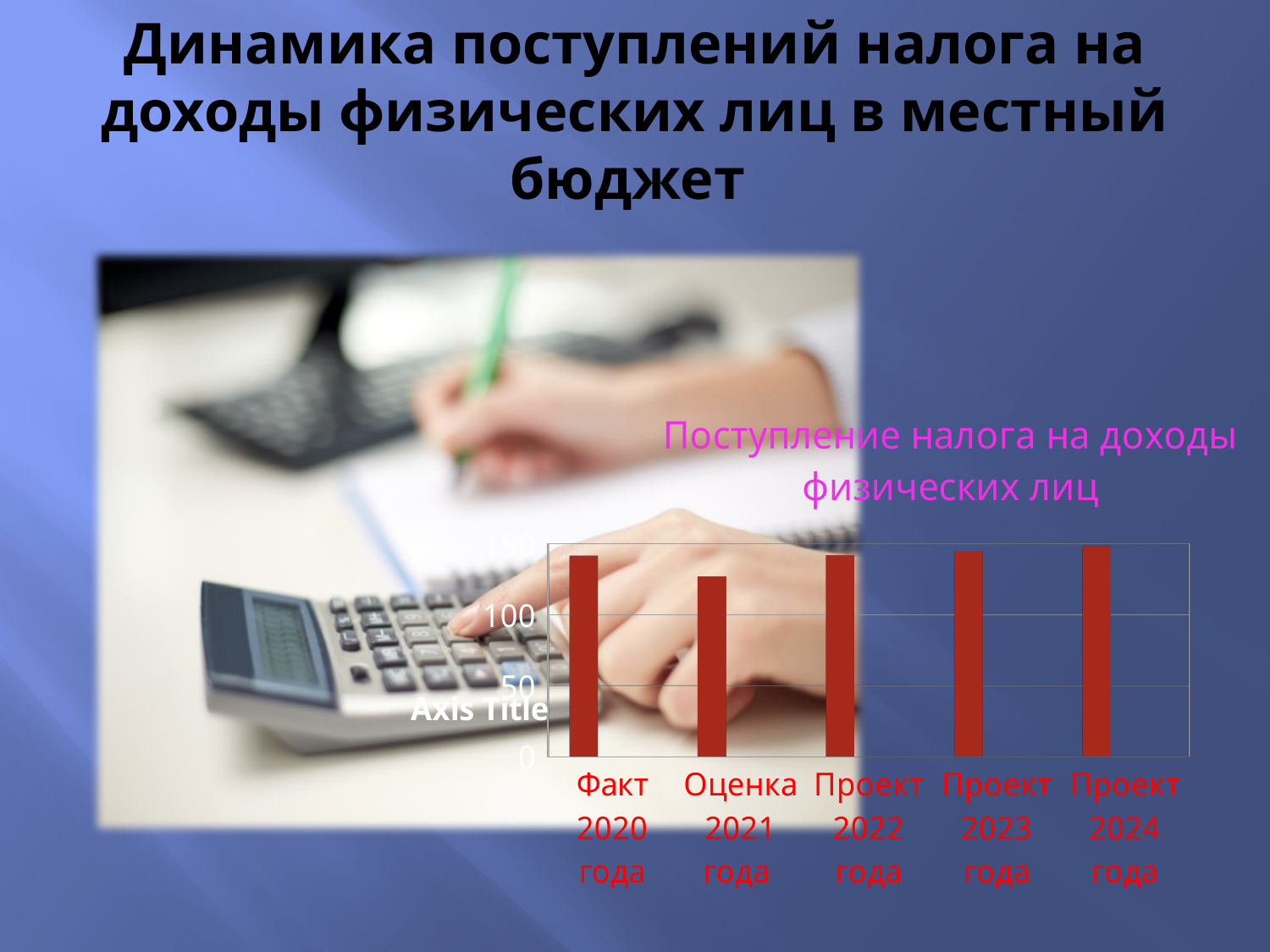
Is the value for Оценка 2021 года greater or less than 150? less Is the value for Проект 2024 года greater or less than 100? greater What kind of chart is shown on the slide? bar chart What is the highest value shown on the vertical axis of the chart? 150 What colour are the bars in the chart? red Is the value for Оценка 2021 года greater or less than 100? greater Which is larger, the value for Оценка 2021 года or for Проект 2022 года? Проект 2022 года Which is larger, the value for Факт 2020 года or for Оценка 2021 года? Факт 2020 года How many categories are plotted in the chart? 5 What is the title of the chart? Поступление налога на доходы физических лиц Which category has the lowest value in the chart? Оценка 2021 года